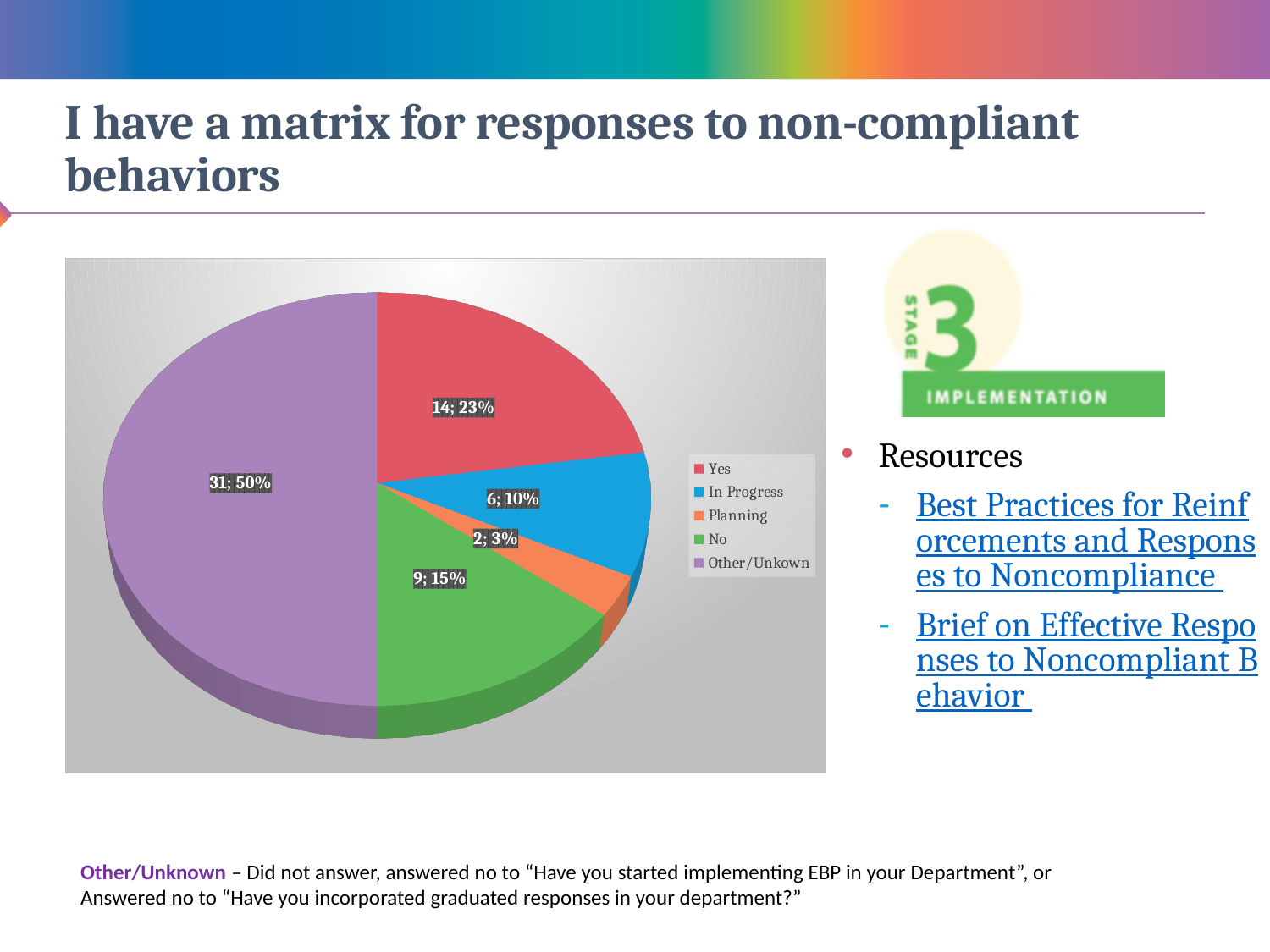
What is the count shown for the Other/Unkown slice? 31 What colour is the Other/Unkown slice in the pie chart? purple What is the count shown for the Yes slice? 14 Which category has the largest slice of the pie? Other/Unkown What percentage of the pie is the No slice? 15% What percentage of the pie is the In Progress slice? 10% What kind of chart is shown on the slide? pie chart How many slices does the pie chart have? 5 What is the difference between the counts for Yes and No? 5 What is the count shown for the Planning slice? 2 Which is larger, the In Progress slice or the No slice? No Which category has the smallest slice of the pie? Planning